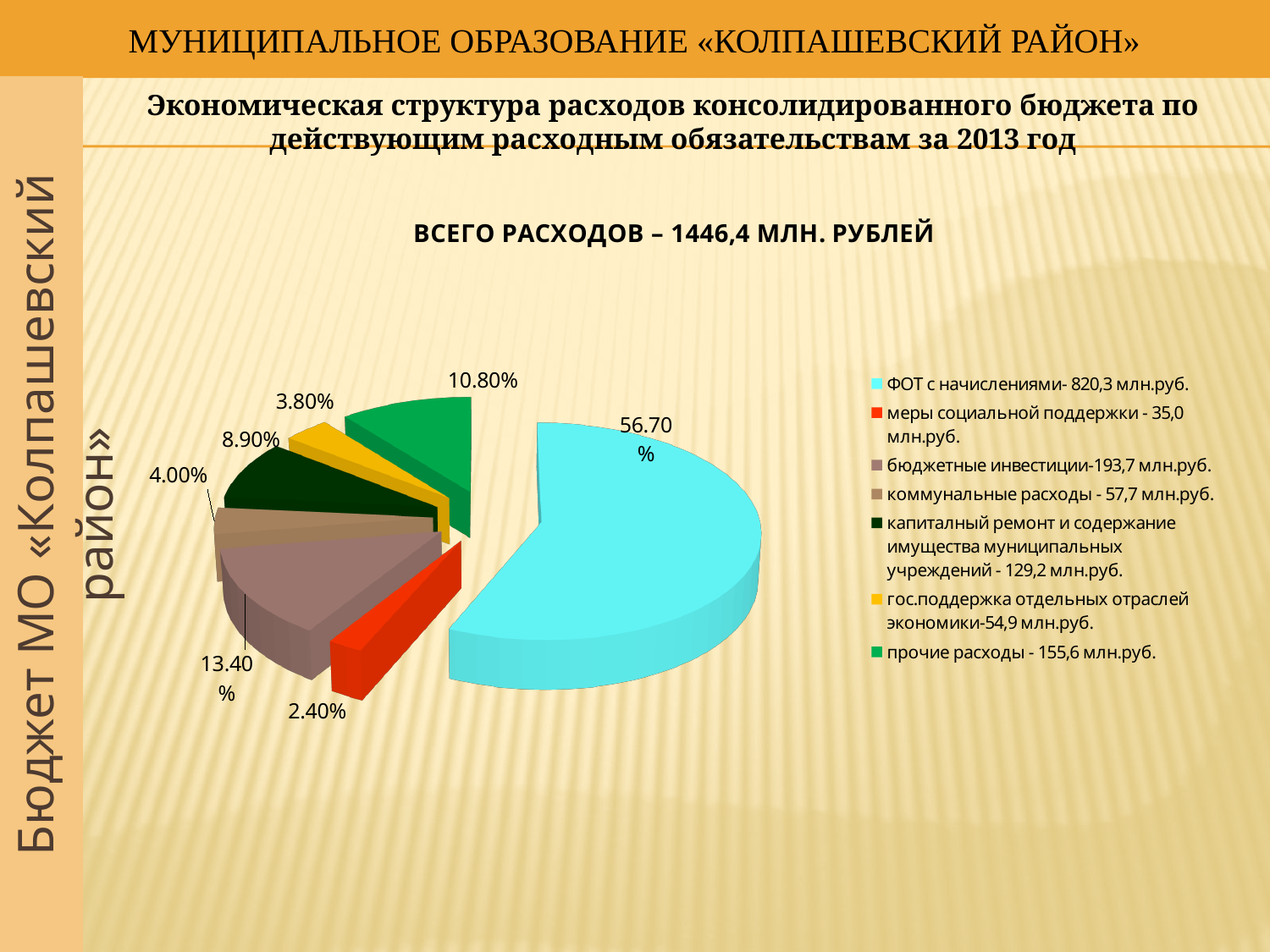
What share of the pie does the slice for «ФОТ с начислениями» take? 56.70% Which category has the largest slice of the pie? ФОТ с начислениями What share of the pie does the slice for «прочие расходы» take? 10.80% What is the difference in percentage points between the «прочие расходы» slice and the «гос.поддержка отдельных отраслей экономики» slice? 7.00% Which category has the smallest slice of the pie? меры социальной поддержки How many slices does the pie chart have? 7 What kind of chart is shown on the slide? pie chart What share of the pie does the slice for «меры социальной поддержки» take? 2.40% What total expenditure amount is stated in the chart title? 1446,4 млн. рублей Which slice is larger: «капиталный ремонт и содержание имущества муниципальных учреждений» or «коммунальные расходы»? капиталный ремонт и содержание имущества муниципальных учреждений According to the legend, what is the amount in млн.руб. for «бюджетные инвестиции»? 193,7 млн.руб.